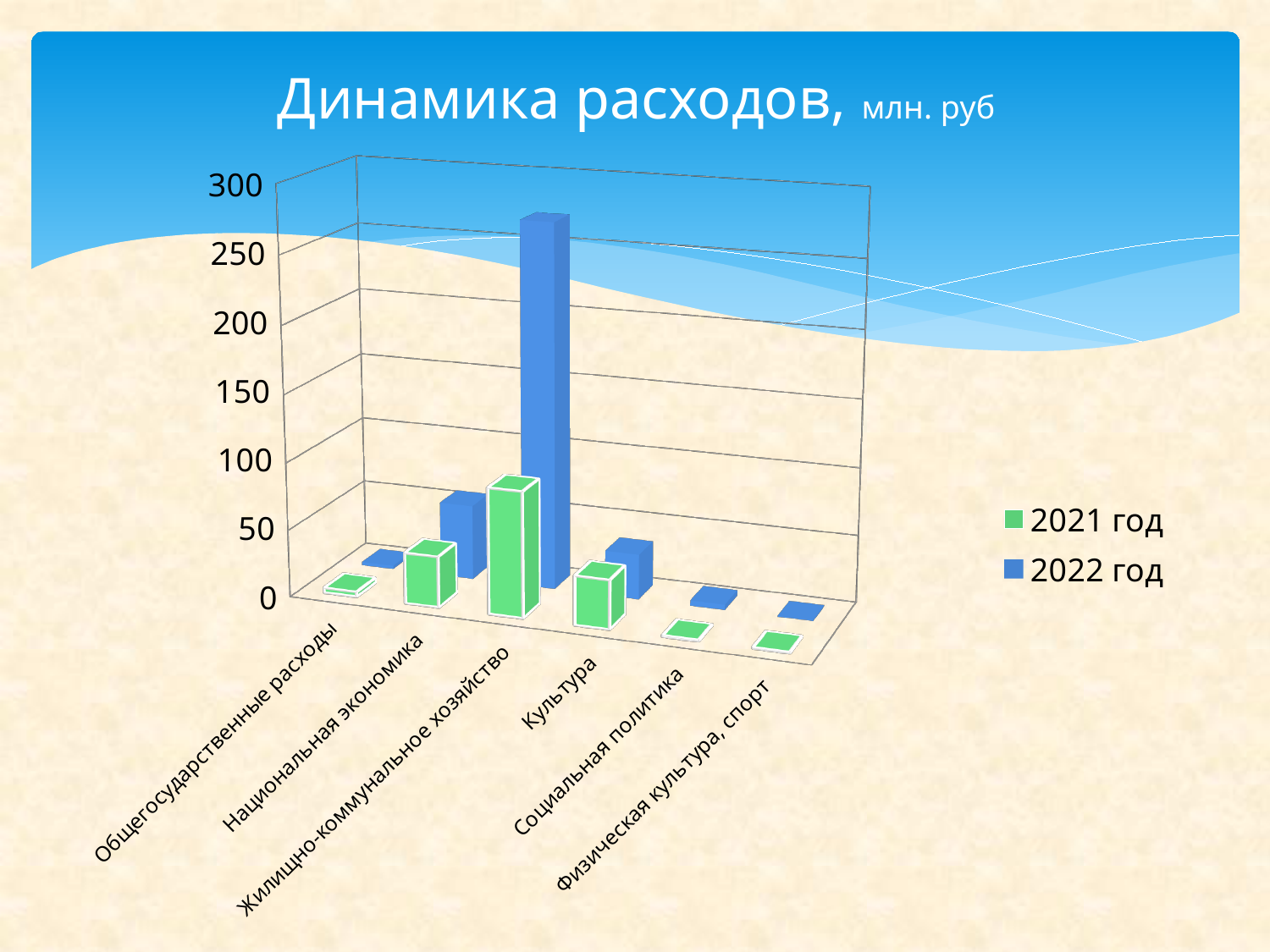
Which category has the highest value for the 2021 год series? Жилищно-коммунальное хозяйство Is the 2021 год value for Жилищно-коммунальное хозяйство greater or less than 50? greater Which colour represents the 2021 год series in the legend? green In the 2021 год series, which is larger: Культура or Общегосударственные расходы? Культура How many categories are shown on the x axis of the chart? 6 Is the 2022 год value for Социальная политика greater or less than 50? less How many series does the legend list? 2 Is the 2022 год value for Жилищно-коммунальное хозяйство greater or less than 200? greater For Жилищно-коммунальное хозяйство, which series has the larger value, 2021 год or 2022 год? 2022 год Which category has the highest value for the 2022 год series? Жилищно-коммунальное хозяйство What kind of chart is shown on the slide? bar chart What is the title of the chart? Динамика расходов, млн. руб